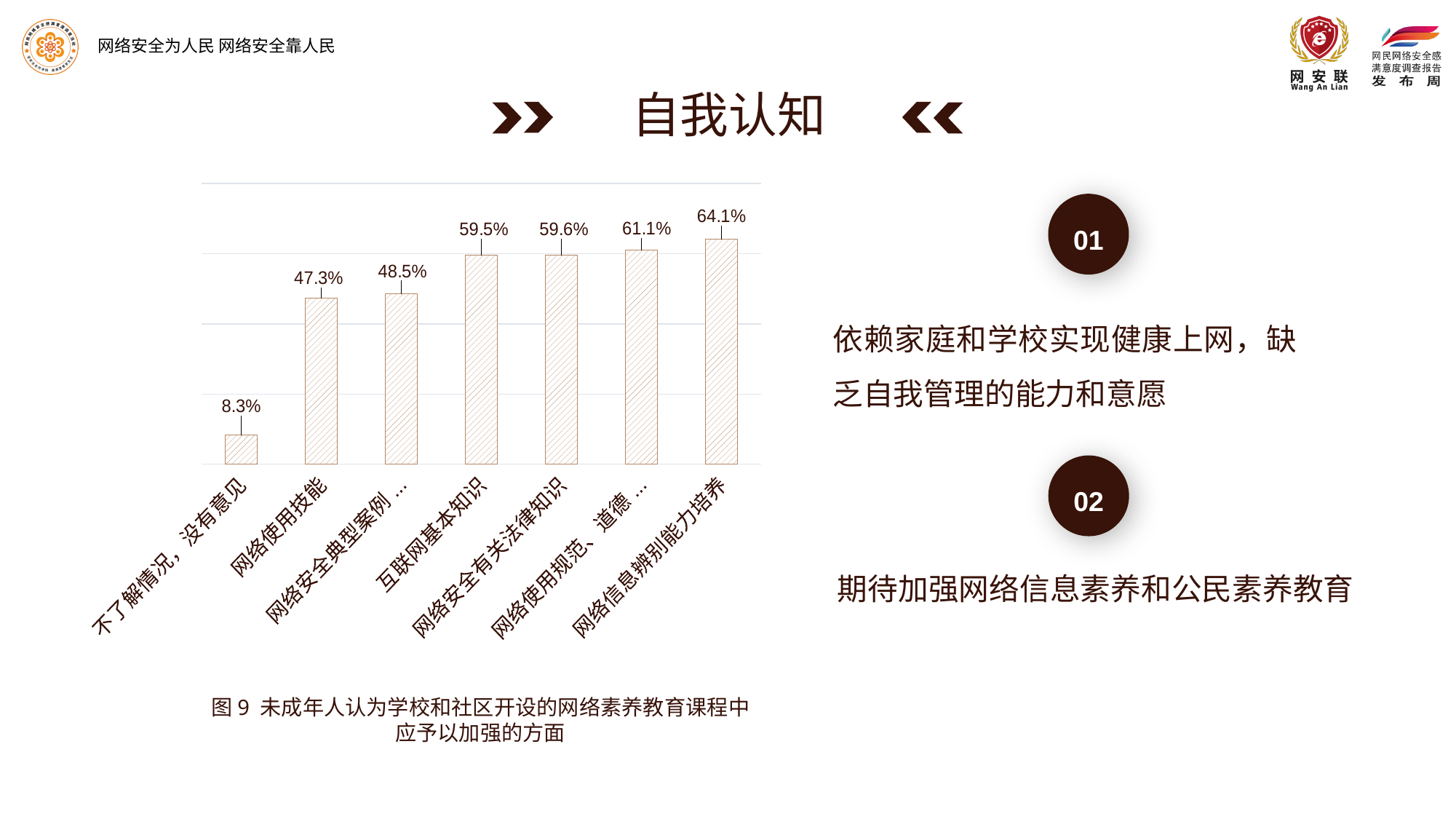
What is the value for 不了解情况，没有意见? 8.3% What kind of chart is shown on the slide? bar chart Which category has the lowest value? 不了解情况，没有意见 What is the value for 互联网基本知识? 59.5% Which is larger, the value for 网络使用技能 or the value for 互联网基本知识? 互联网基本知识 What is the value for 网络信息辨别能力培养? 64.1% How many categories are plotted in the chart? 7 Which category has the highest value? 网络信息辨别能力培养 What is the value for 网络使用技能? 47.3% Do the values rise or fall from left to right along the x axis? rise What is the difference between the values for 网络信息辨别能力培养 and 不了解情况，没有意见? 55.8% What is the value for 网络安全有关法律知识? 59.6%